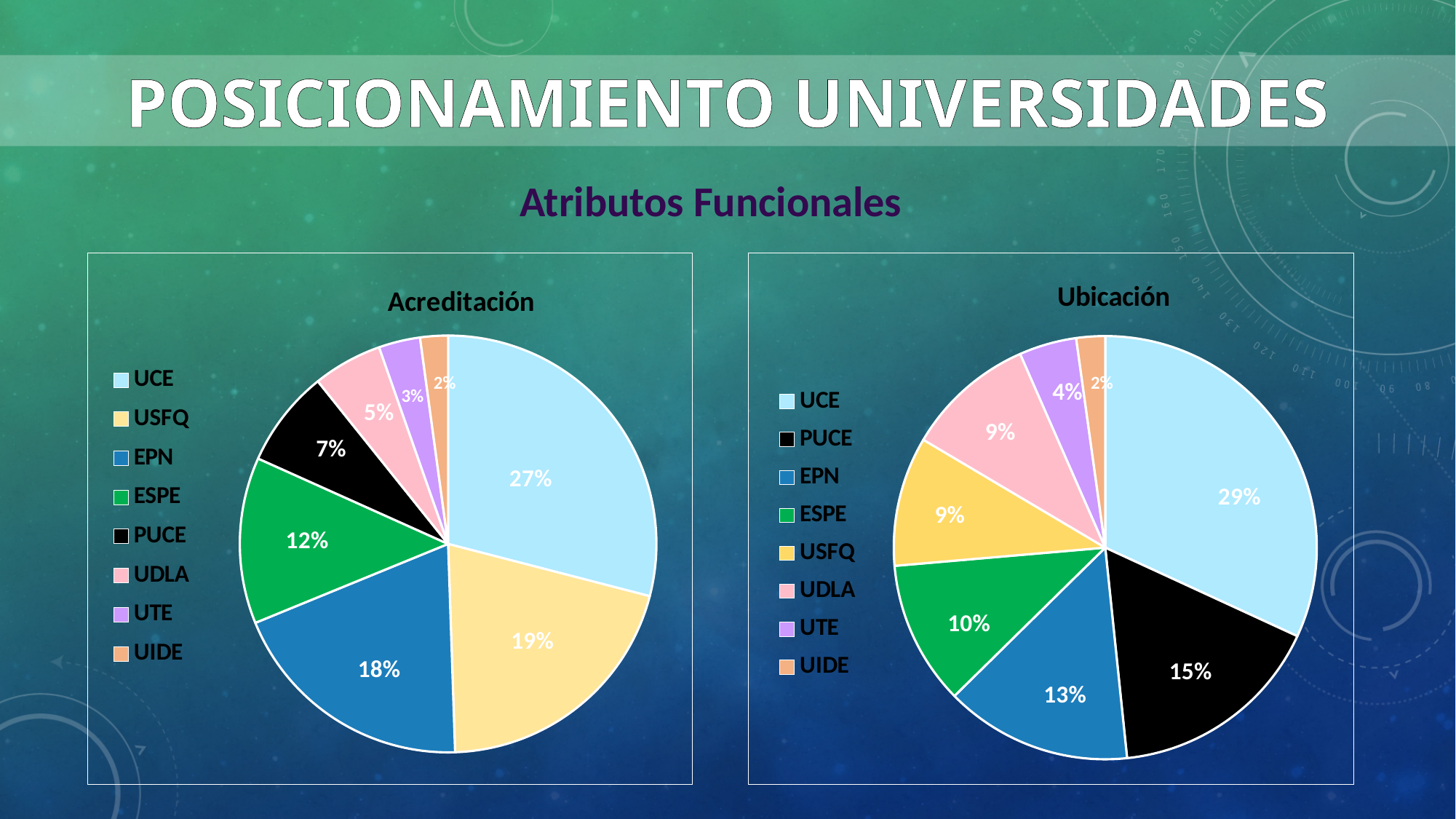
In the Acreditación chart, what share does UTE have? 3% In the Acreditación chart, what is the difference between the USFQ and EPN shares? 1% In the Acreditación chart, what share does ESPE have? 12% In the Acreditación chart, what share does UCE have? 27% What type of chart is the Ubicación chart? Pie chart In the Acreditación chart, which university has the largest slice? UCE In the Ubicación chart, what is the difference between the UCE and PUCE shares? 14% How many slices does the Acreditación pie chart have? 8 In the Ubicación chart, which university has the smallest slice? UIDE In the Ubicación chart, what share does PUCE have? 15% In the Ubicación chart, which is larger, the share for EPN or the share for ESPE? EPN What is the title of the chart on the left? Acreditación